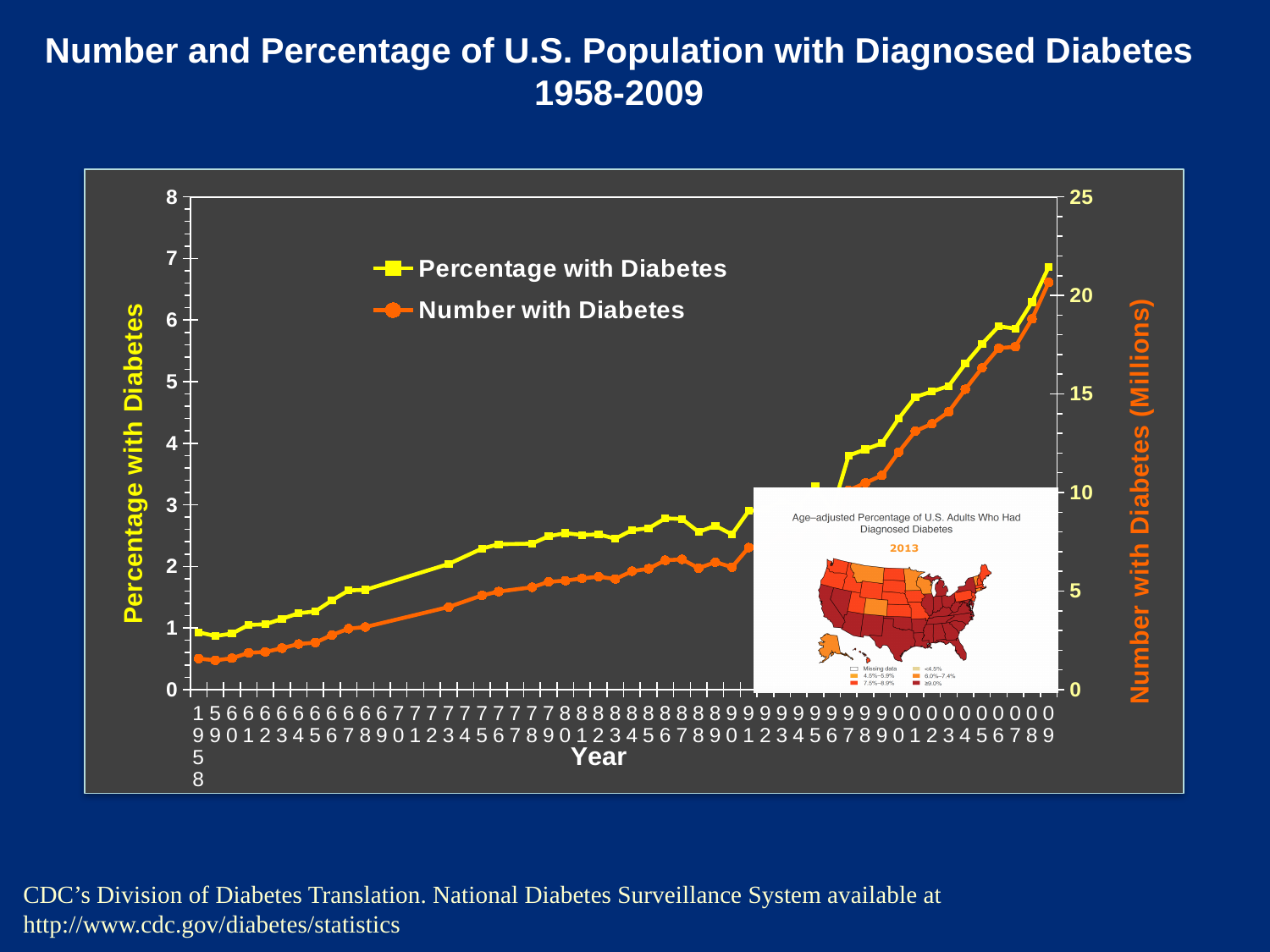
Over the years shown, does the Percentage with Diabetes series generally rise or fall? Rise What are the two series named in the legend? Percentage with Diabetes; Number with Diabetes What is the label of the left vertical axis? Percentage with Diabetes Is the Percentage with Diabetes in 1958 greater or less than 2? less Is the Percentage with Diabetes in 2009 greater or less than 6? greater Is the Number with Diabetes in 2000 greater or less than 10 million? greater Which is larger, the Percentage with Diabetes in 1990 or in 2005? 2005 In which year is the Number with Diabetes highest? 2009 In which year is the Percentage with Diabetes highest? 2009 What kind of chart is shown on the slide? Line chart Over the years shown, does the Number with Diabetes series generally rise or fall? Rise How many series does the legend list? 2